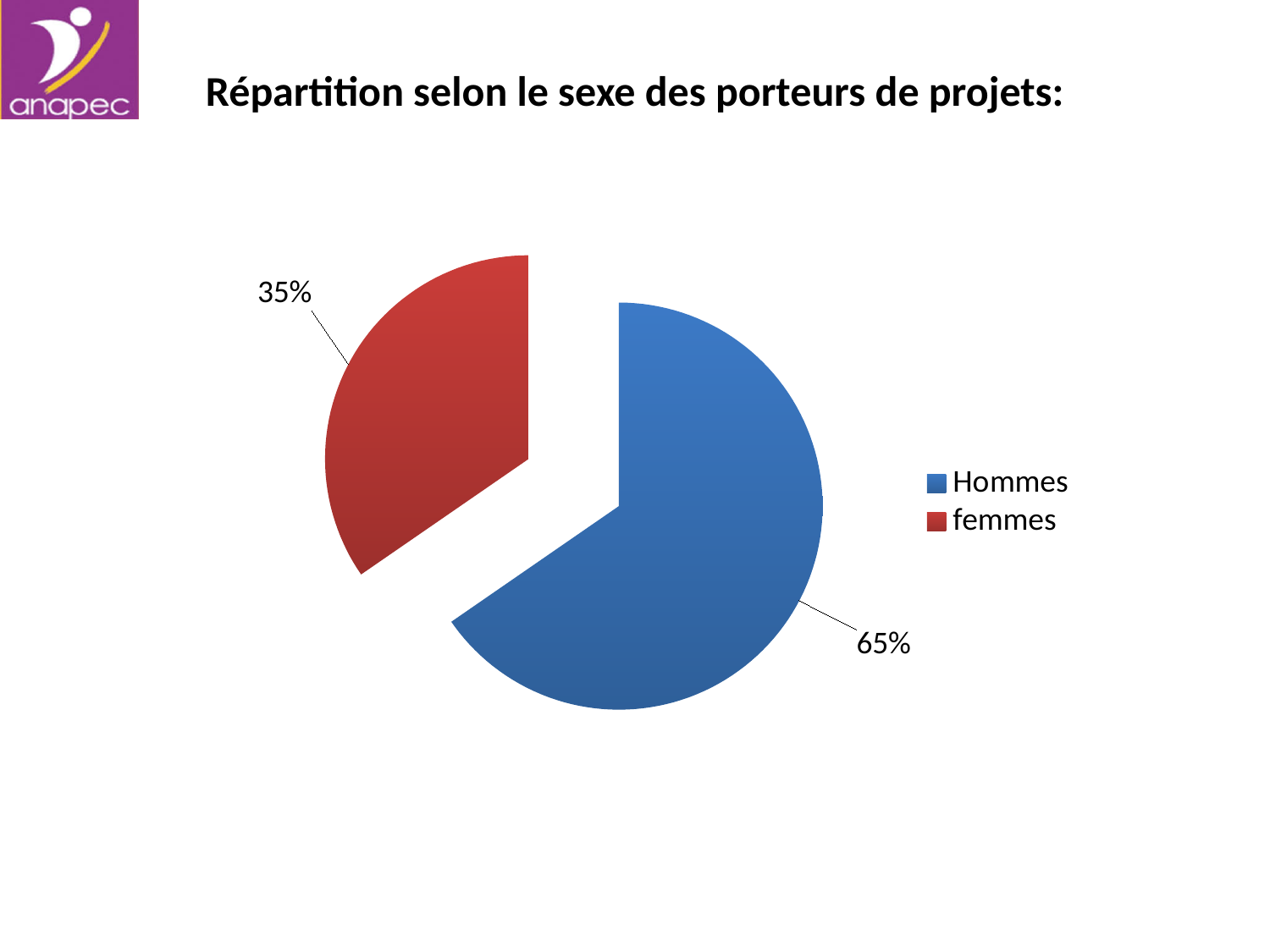
Which category has the largest slice of the pie? Hommes What share of the pie is labelled for femmes? 35% What is the title of the slide above the chart? Répartition selon le sexe des porteurs de projets: What share of the pie is labelled for Hommes? 65% How many entries does the legend list? 2 What colour is the Hommes slice? Blue What kind of chart is shown on the slide? Pie chart What is the difference in percentage points between the Hommes and femmes slices? 30 percentage points How many categories does the pie chart show? 2 Which slice is larger, Hommes or femmes? Hommes Which category has the smallest slice of the pie? femmes